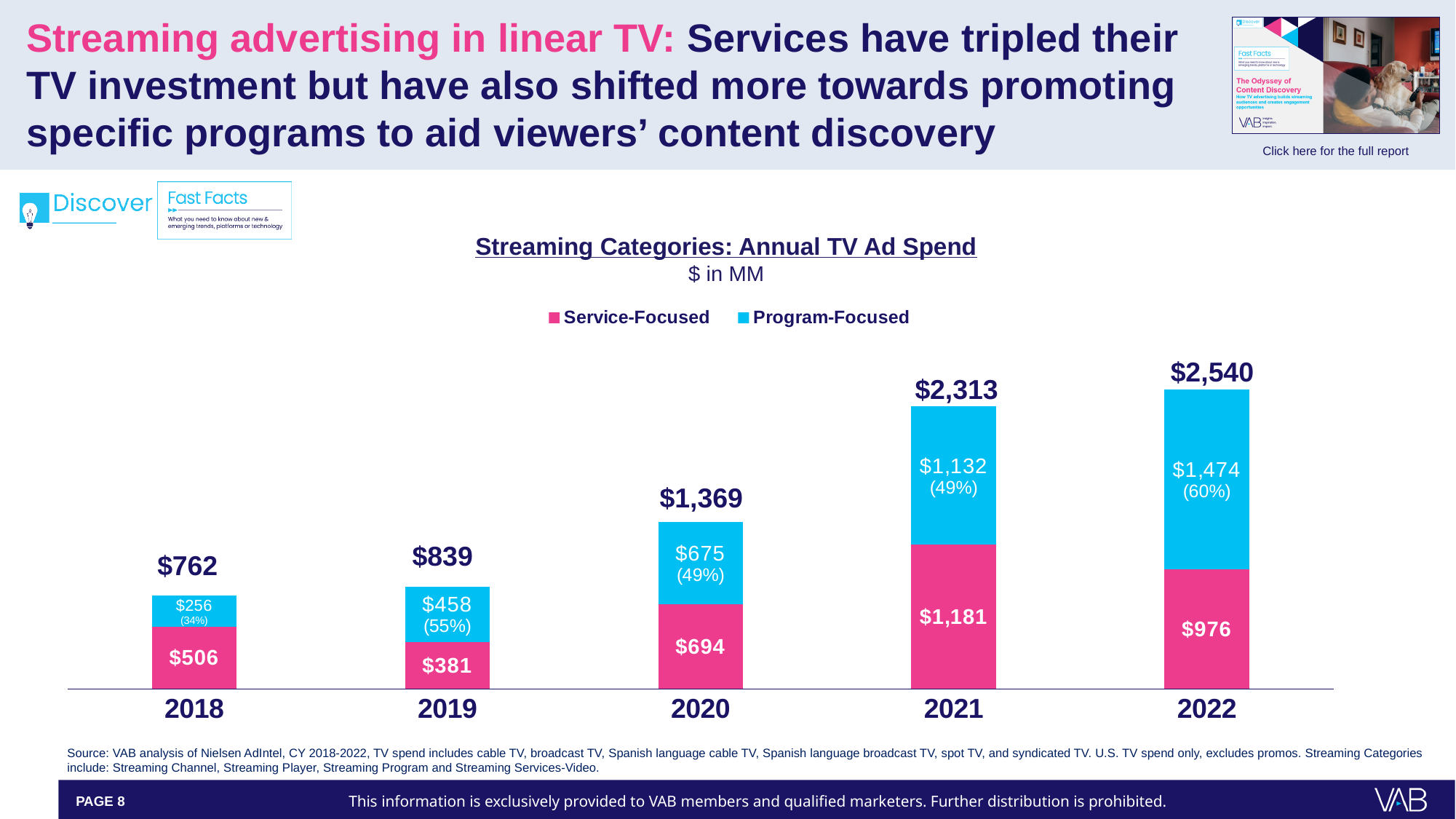
How many years are shown on the x axis? 5 What is the total annual TV ad spend shown for 2020? $1,369 Which is larger in 2021, the Service-Focused spend or the Program-Focused spend? Service-Focused What percentage of the 2019 total is Program-Focused? 55% How many series does the legend list? 2 Which year has the highest total annual TV ad spend? 2022 Does the total annual TV ad spend rise or fall from 2018 to 2022? Rise What is the Program-Focused TV ad spend for 2022? $1,474 What is the difference between the total ad spend in 2022 and in 2021? $227 Which year has the lowest total annual TV ad spend? 2018 What kind of chart is shown on the slide? Stacked bar chart What is the Service-Focused TV ad spend for 2018? $506